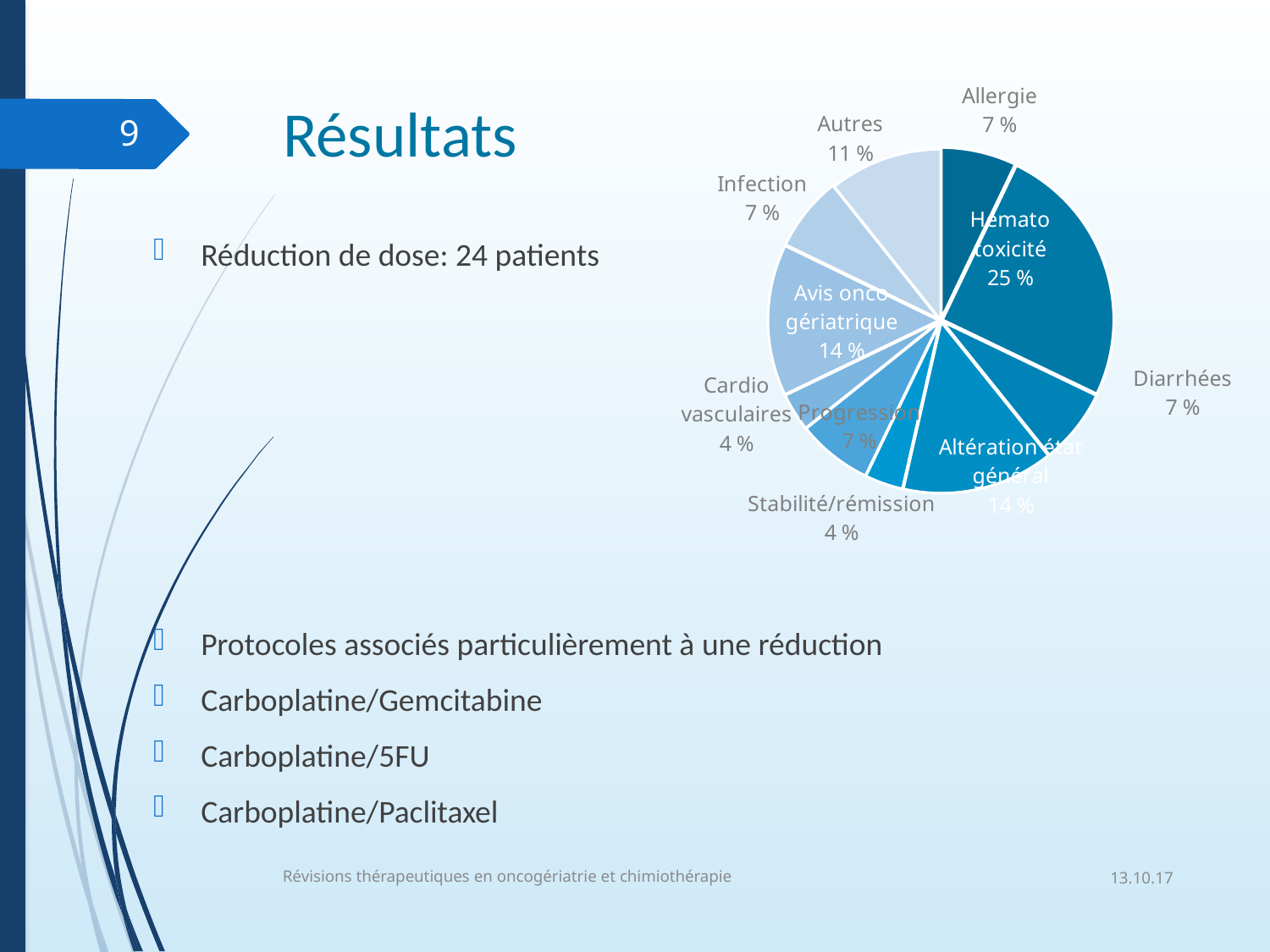
What is the difference between the Hémato toxicité and Altération état général shares in the pie chart? 11 % What is the value shown for Autres in the pie chart? 11 % What is the value shown for Stabilité/rémission in the pie chart? 4 % How many slices does the pie chart have? 10 Which is larger in the pie chart, Avis onco-gériatrique or Progression? Avis onco-gériatrique What kind of chart is shown on the slide? pie chart What share of the pie chart does Hémato toxicité represent? 25 % Which category has the largest slice in the pie chart? Hémato toxicité What is the value shown for Allergie in the pie chart? 7 % What is the value shown for Avis onco-gériatrique in the pie chart? 14 % What is the difference between the Autres and Cardio vasculaires shares in the pie chart? 7 % Which is larger in the pie chart, Autres or Infection? Autres